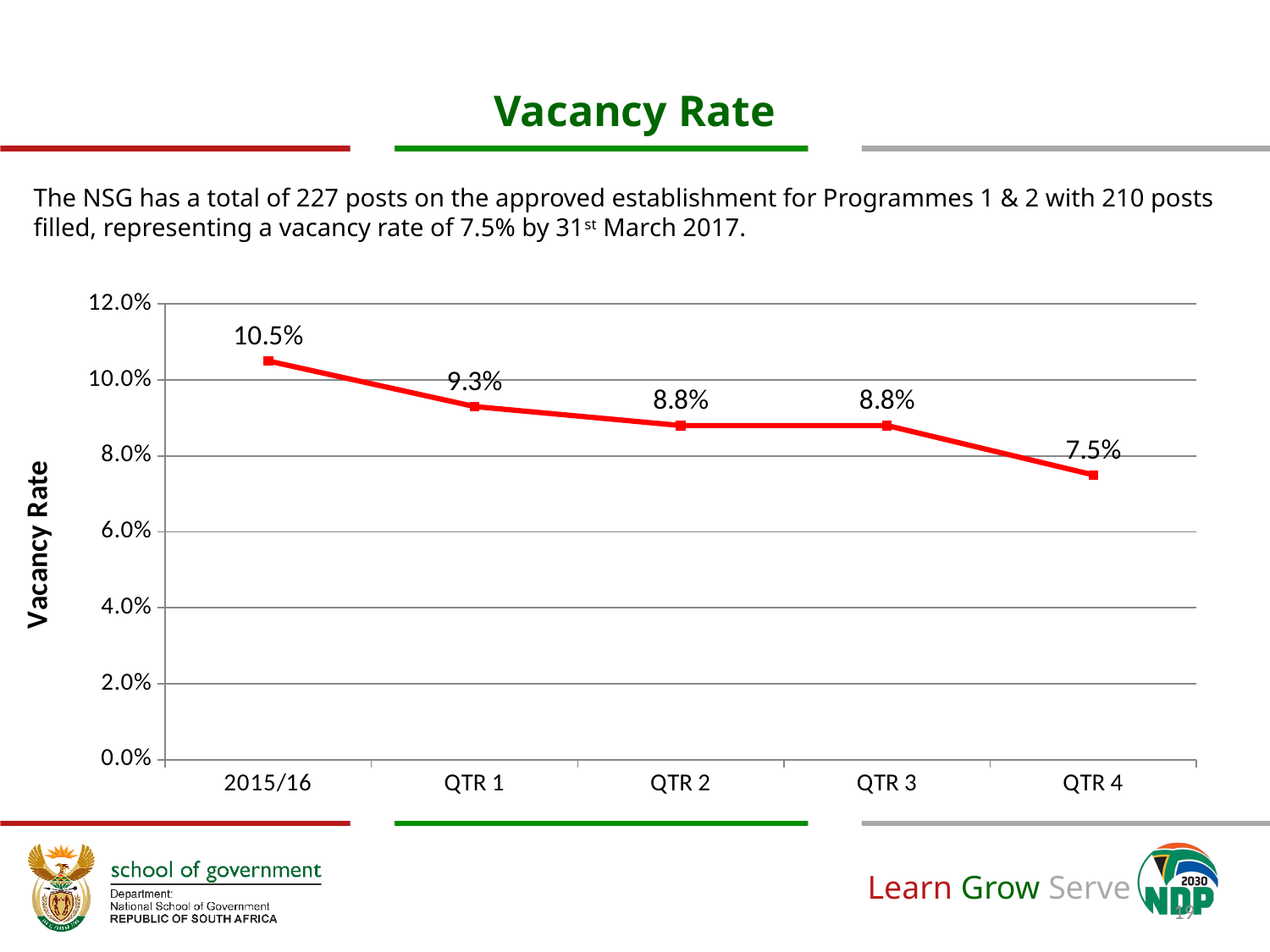
Which category has the lowest vacancy rate? QTR 4 Do the vacancy rate values rise or fall from 2015/16 to QTR 4? fall Which is larger, the vacancy rate for QTR 1 or QTR 4? QTR 1 Is the vacancy rate for QTR 3 greater or less than 8.0%? greater What is the difference between the vacancy rate for QTR 1 and QTR 2? 0.5% What is the difference between the vacancy rate for 2015/16 and QTR 4? 3.0% What is the vacancy rate for QTR 4? 7.5% What is the vacancy rate for 2015/16? 10.5% What kind of chart is shown on the slide? line chart Which category has the highest vacancy rate? 2015/16 What is the vacancy rate for QTR 1? 9.3% How many categories are plotted on the x axis? 5